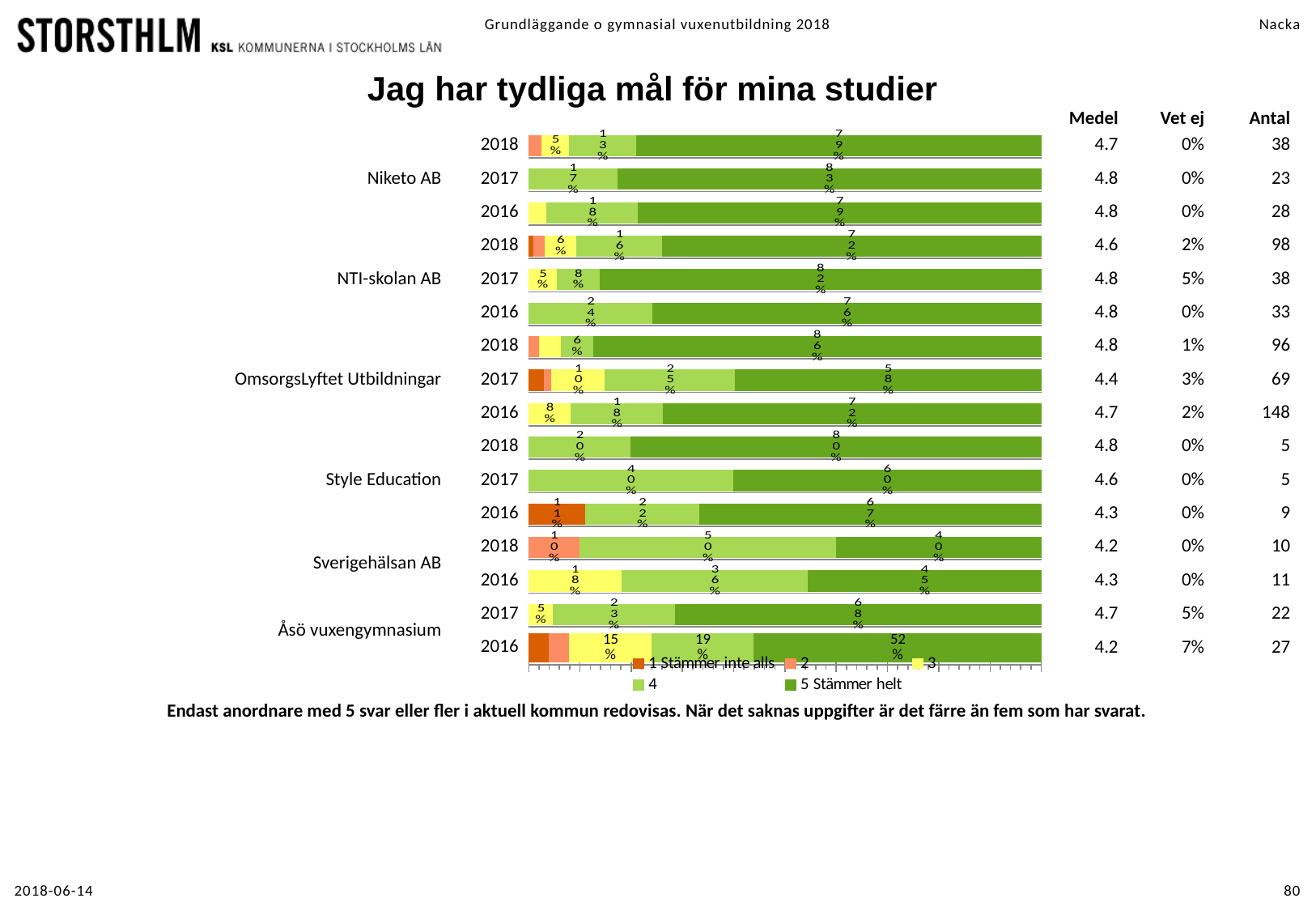
For Style Education in 2017, what is the difference between the '5 Stämmer helt' share and the '4' share? 20 percentage points Which bar has the lowest share of '5 Stämmer helt'? Sverigehälsan AB 2018 What kind of chart is shown on the slide? bar chart Which bar has the highest share of '5 Stämmer helt'? OmsorgsLyftet Utbildningar 2018 What is the value of '5 Stämmer helt' for Åsö vuxengymnasium in 2016? 52% What is the title of the chart? Jag har tydliga mål för mina studier How many bars are plotted in the chart? 16 What is the value of '4' for Sverigehälsan AB in 2018? 50% What is the value of '5 Stämmer helt' for Style Education in 2018? 80% What is the value of '3' for Åsö vuxengymnasium in 2016? 15% What is the value of '5 Stämmer helt' for Niketo AB in 2017? 83% How many series does the chart legend list? 5